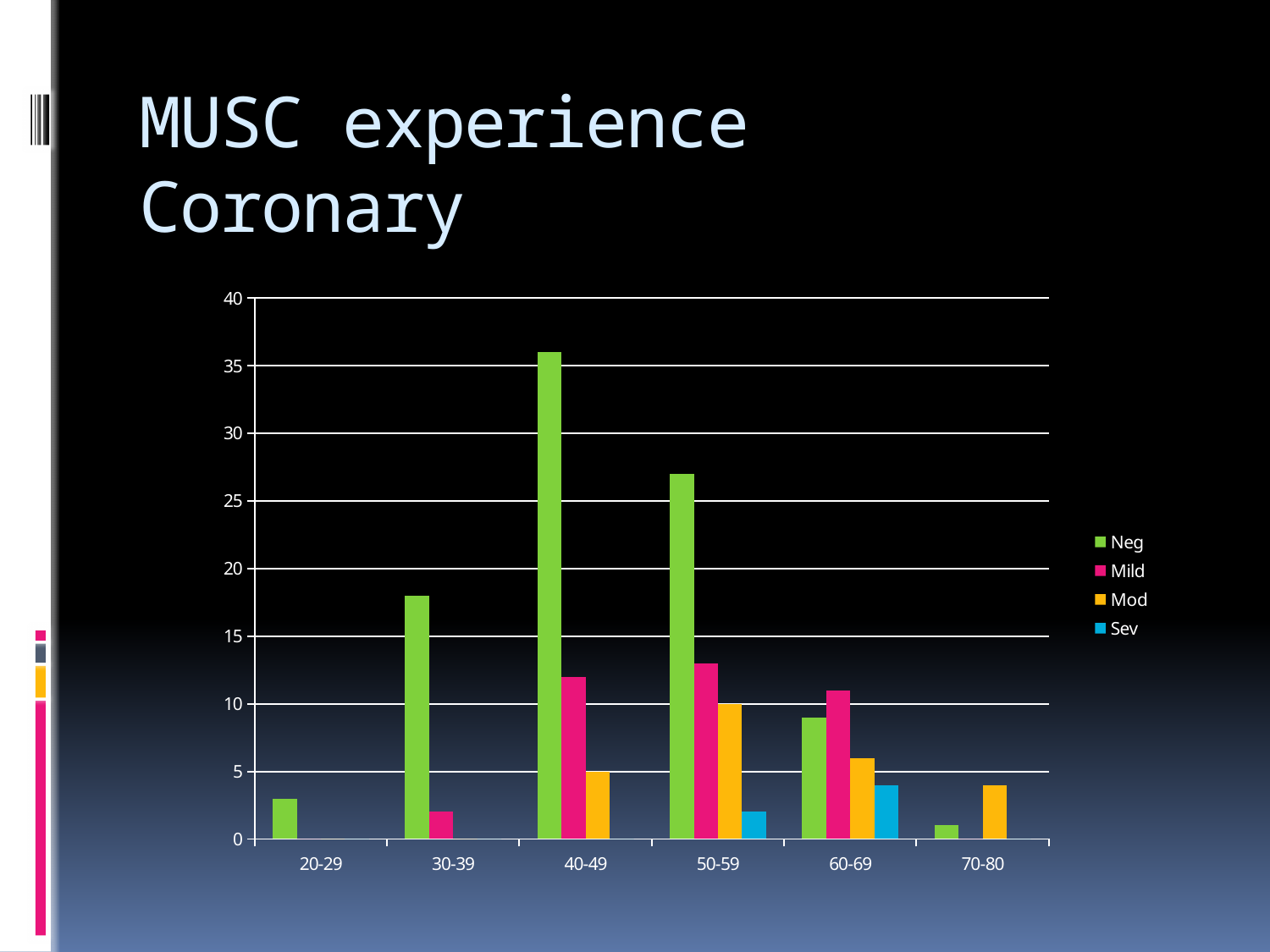
Does the Neg value rise or fall from 40-49 to 70-80? fall How many age groups are shown on the x axis? 6 Which age group has the highest Neg value? 40-49 Is the Neg value for 40-49 greater or less than 35? greater Which is larger, the Neg value for 40-49 or the Neg value for 50-59? 40-49 Is the Neg value for 60-69 greater or less than 10? less How many series does the legend list? 4 What are the four series listed in the legend? Neg, Mild, Mod, Sev What kind of chart is shown on the slide? bar chart Is the Sev value for 60-69 greater or less than 5? less Which age group has the lowest Neg value? 70-80